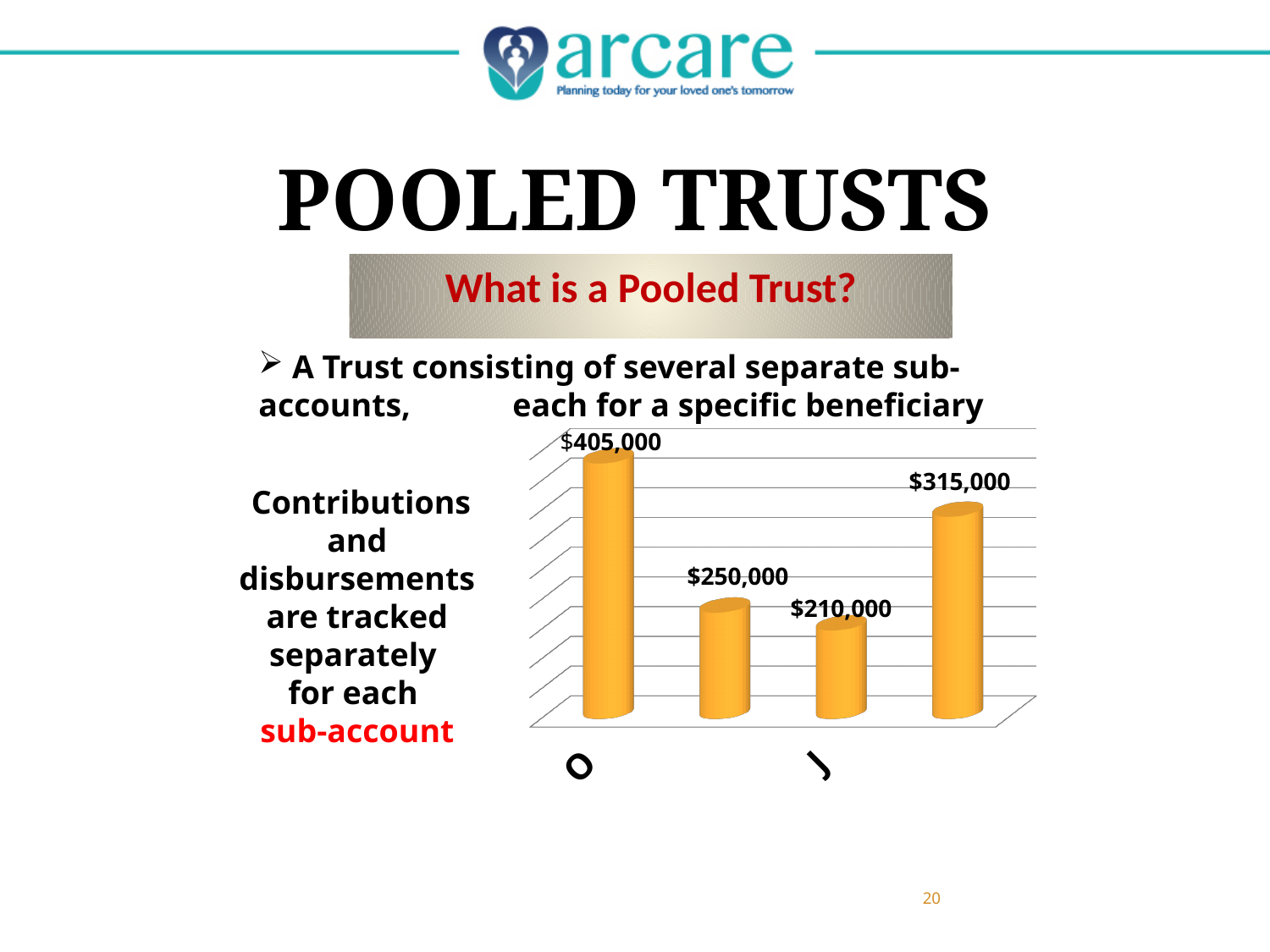
What is the difference between the leftmost bar ($405,000) and the rightmost bar ($315,000)? $90,000 Which is larger, the second bar from the left or the fourth bar from the left? the fourth bar ($315,000) What is the lowest value shown in the chart? $210,000 What is the difference between the second bar ($250,000) and the third bar ($210,000)? $40,000 What is the highest value shown in the chart? $405,000 What is the value of the second bar from the left in the chart? $250,000 What is the value of the fourth (rightmost) bar in the chart? $315,000 How many bars are plotted in the chart? 4 What is the value of the third bar from the left in the chart? $210,000 What is the value of the first (leftmost) bar in the chart? $405,000 What colour are the bars in the chart? orange What kind of chart is shown on the slide? bar chart